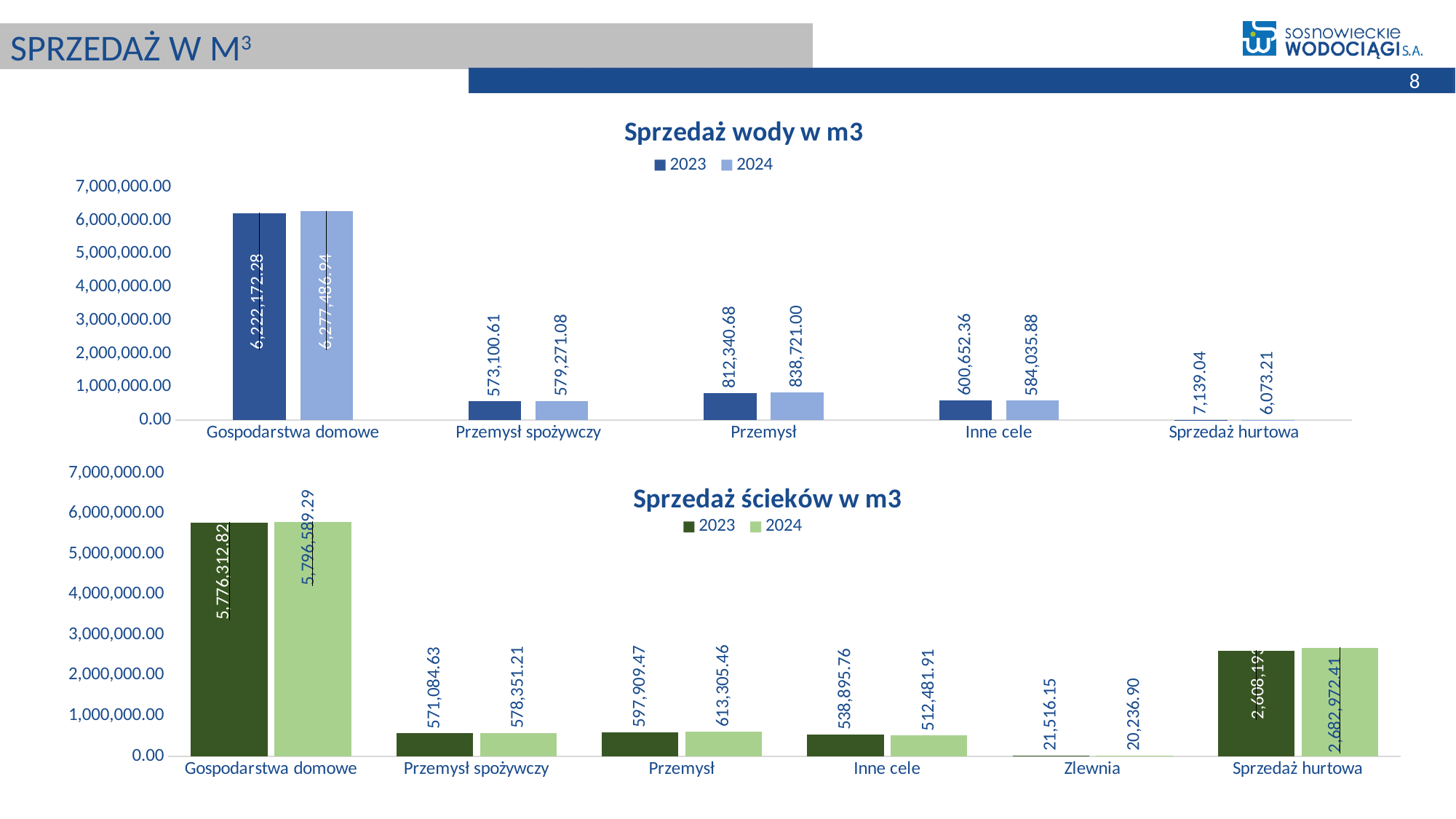
In the 'Sprzedaż ścieków w m3' chart, what is the 2023 value for Zlewnia? 21,516.15 In the 'Sprzedaż wody w m3' chart, which category has the lowest 2024 value? Sprzedaż hurtowa In the 'Sprzedaż ścieków w m3' chart, which is larger for Inne cele: the 2023 value or the 2024 value? 2023 In the 'Sprzedaż wody w m3' chart, which category has the highest 2023 value? Gospodarstwa domowe How many series does the legend of the 'Sprzedaż ścieków w m3' chart list? 2 In the 'Sprzedaż ścieków w m3' chart, what is the 2024 value for Sprzedaż hurtowa? 2,682,972.41 In the 'Sprzedaż wody w m3' chart, what is the 2023 value for Sprzedaż hurtowa? 7,139.04 In the 'Sprzedaż ścieków w m3' chart, what is the 2024 value for Przemysł? 613,305.46 In the 'Sprzedaż wody w m3' chart, what is the 2023 value for Przemysł? 812,340.68 In the 'Sprzedaż ścieków w m3' chart, how many categories are shown on the x axis? 6 In the 'Sprzedaż wody w m3' chart, how many categories are shown on the x axis? 5 In the 'Sprzedaż wody w m3' chart, what is the 2024 value for Inne cele? 584,035.88